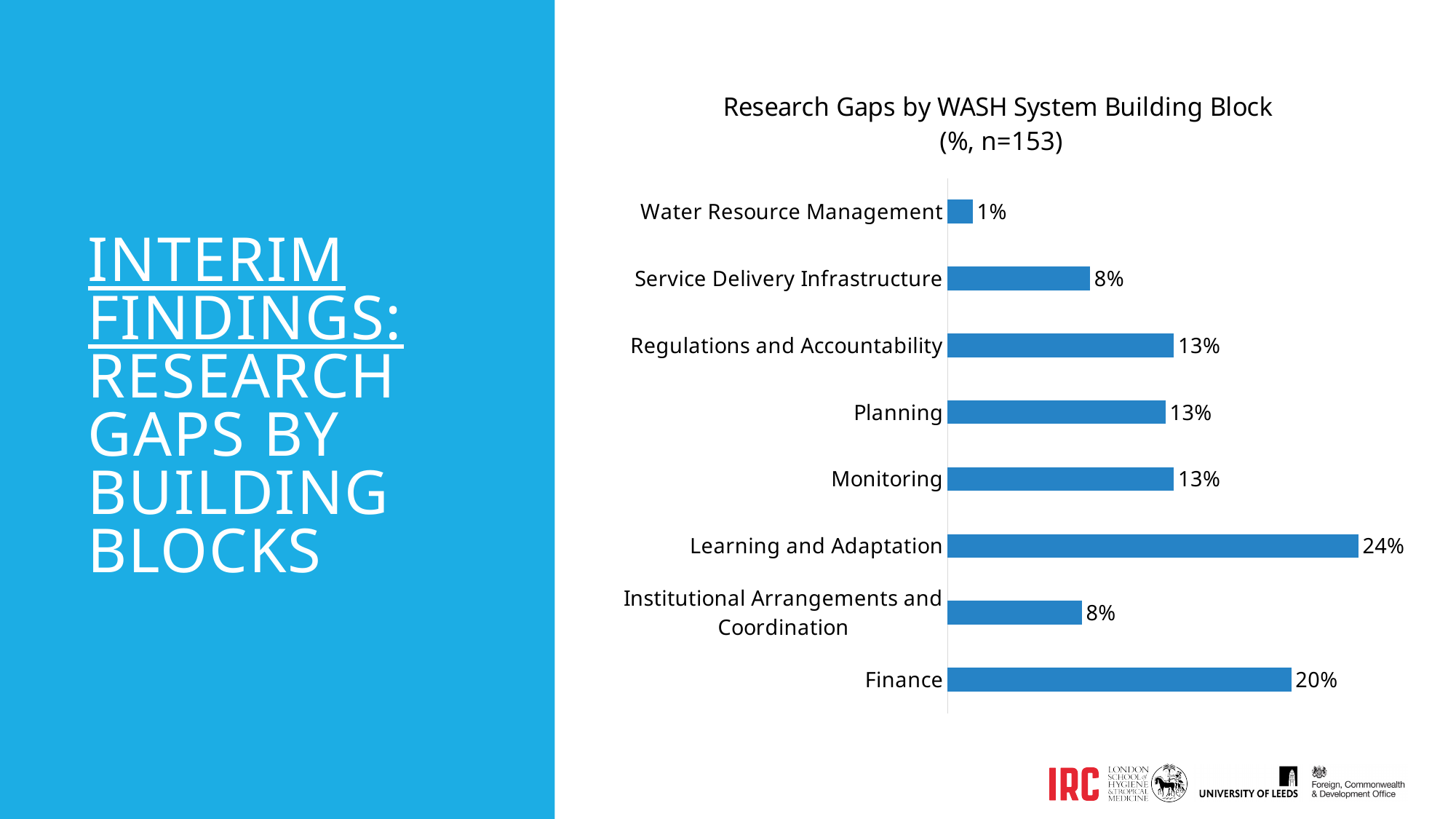
Which building block has the highest value? Learning and Adaptation What is the value for Finance? 20% What is the value for Institutional Arrangements and Coordination? 8% What kind of chart is shown on the slide? Bar chart How many building blocks have a value of 13%? 3 What is the difference between the values for Regulations and Accountability and Service Delivery Infrastructure? 5% What is the value for Water Resource Management? 1% Which is larger, the value for Finance or the value for Monitoring? Finance Which building block has the lowest value? Water Resource Management How many building blocks are shown in the chart? 8 What is the title of the chart? Research Gaps by WASH System Building Block (%, n=153) What is the difference between the values for Learning and Adaptation and Finance? 4%